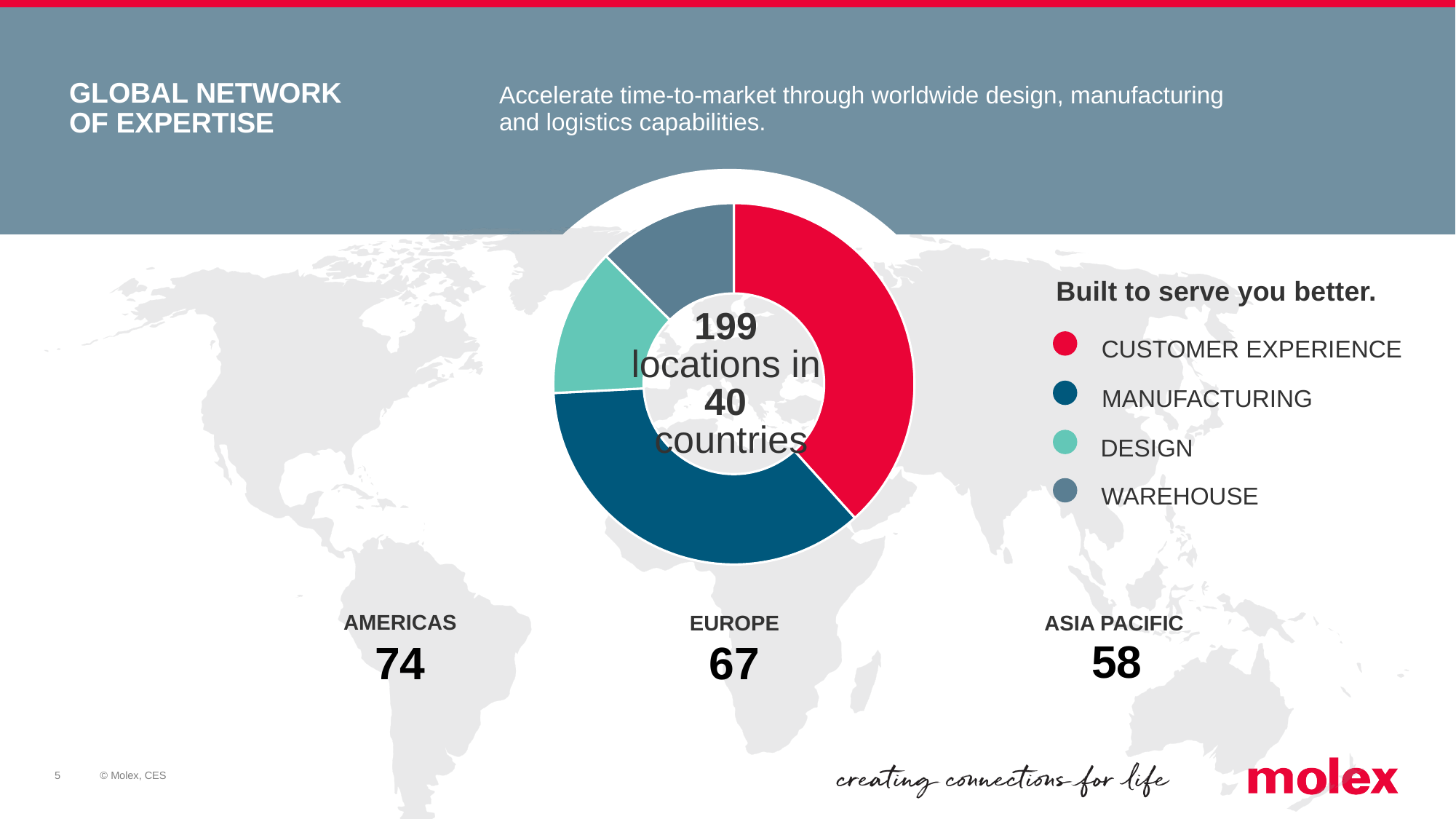
What kind of chart is shown in the centre of the slide? donut chart Which segment of the donut chart is larger, Manufacturing or Warehouse? Manufacturing Which region has the lowest number of locations: Americas, Europe or Asia Pacific? Asia Pacific What total number of locations is printed in the centre of the donut chart? 199 What colour represents Customer Experience in the donut chart? red How many categories does the legend under 'Built to serve you better.' list? 4 What is the difference between the number of locations in the Americas and in Asia Pacific? 16 Which segment of the donut chart is larger, Customer Experience or Design? Customer Experience Which region has the highest number of locations: Americas, Europe or Asia Pacific? Americas How many segments does the donut chart have? 4 How many locations are shown for the Americas? 74 In how many countries are the locations, according to the centre of the donut chart? 40